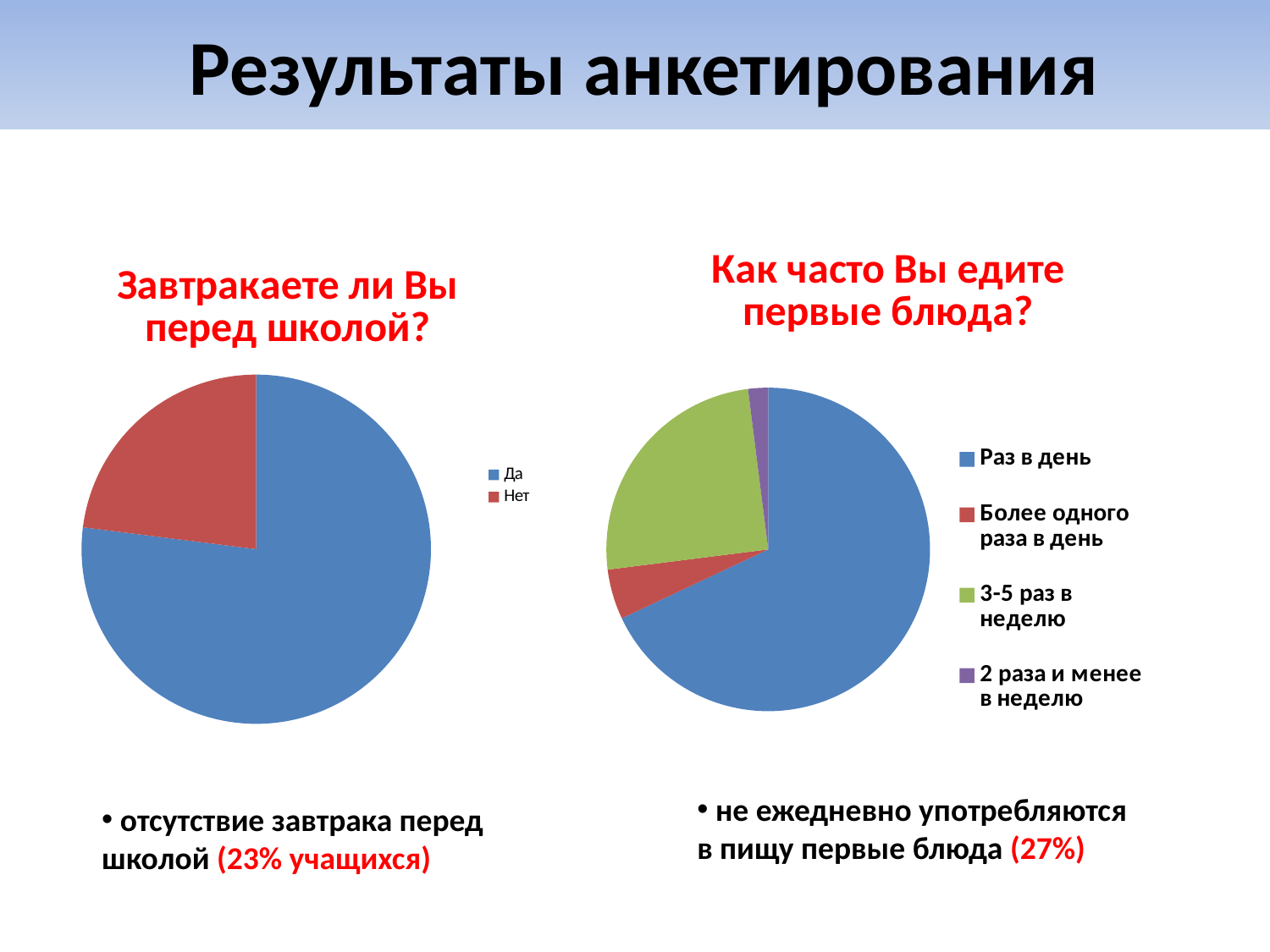
In the left chart "Завтракаете ли Вы перед школой?", what share of students answered "Нет" according to the slide? 23% In the right chart "Как часто Вы едите первые блюда?", how many categories does the legend list? 4 What kind of chart is the left chart titled "Завтракаете ли Вы перед школой?"? pie chart In the right chart "Как часто Вы едите первые блюда?", which category has the smallest slice? 2 раза и менее в неделю In the right chart "Как часто Вы едите первые блюда?", which slice is larger: "3-5 раз в неделю" or "Более одного раза в день"? 3-5 раз в неделю What kind of chart is the right chart titled "Как часто Вы едите первые блюда?"? pie chart In the left chart "Завтракаете ли Вы перед школой?", which answer has the largest slice? Да In the left chart "Завтракаете ли Вы перед школой?", which answer has the smallest slice? Нет In the left chart "Завтракаете ли Вы перед школой?", what colour is the slice for "Нет"? red In the right chart "Как часто Вы едите первые блюда?", what colour is the slice for "Раз в день"? blue In the right chart "Как часто Вы едите первые блюда?", which category has the largest slice? Раз в день In the left chart "Завтракаете ли Вы перед школой?", how many slices does the pie have? 2